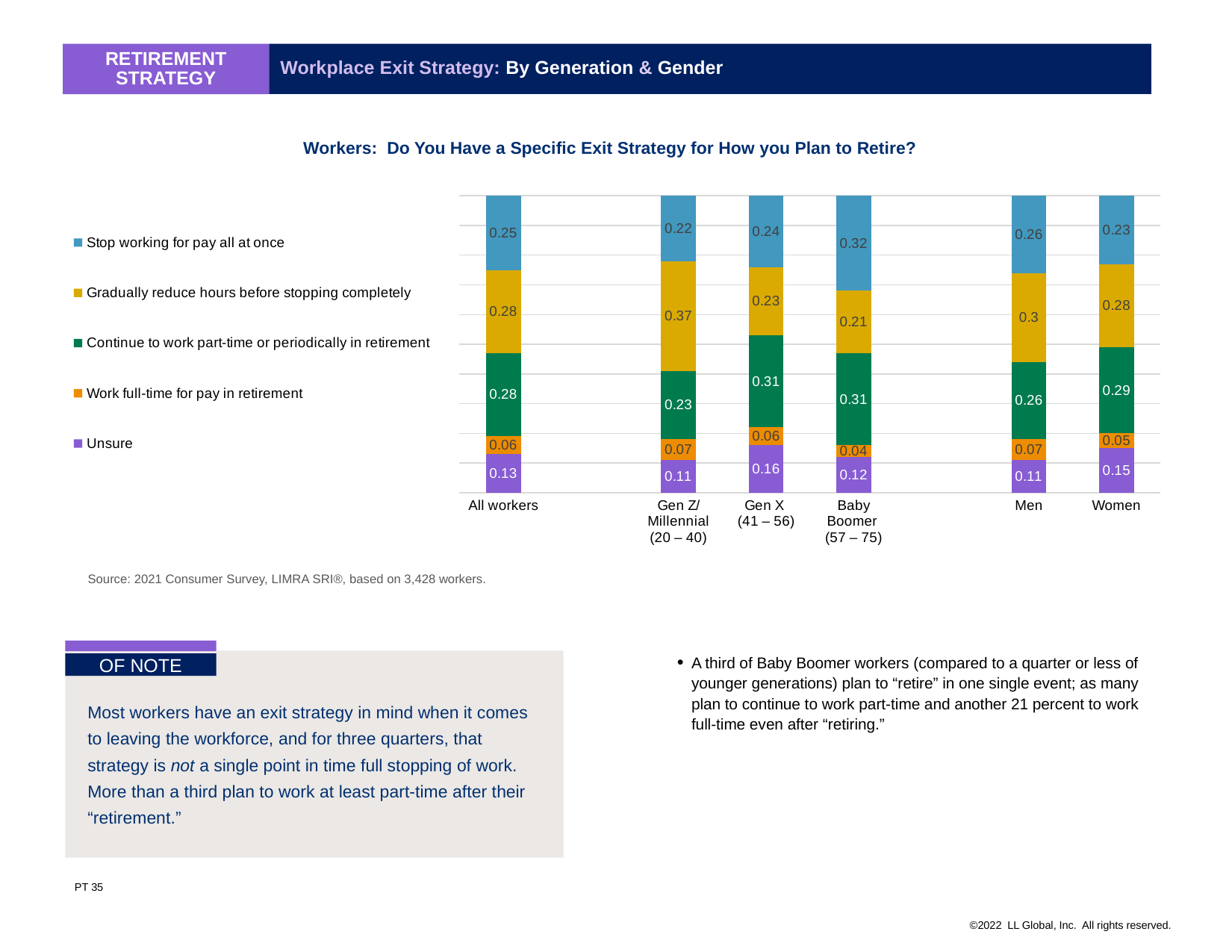
What kind of chart is shown on the slide? Stacked bar chart Which category has the highest value for 'Stop working for pay all at once'? Baby Boomer (57 – 75) What is the 'Unsure' value for Women? 0.15 What is the value for 'Stop working for pay all at once' for Baby Boomer (57 – 75)? 0.32 Which has the larger 'Unsure' value, Gen X (41 – 56) or Gen Z/Millennial (20 – 40)? Gen X (41 – 56) Which category has the lowest value for 'Work full-time for pay in retirement'? Baby Boomer (57 – 75) What is the difference between Men and Women for 'Stop working for pay all at once'? 0.03 How many series does the chart's legend list? 5 What is the value for 'Gradually reduce hours before stopping completely' for Gen Z/Millennial (20 – 40)? 0.37 What is the title of the chart? Workers: Do You Have a Specific Exit Strategy for How you Plan to Retire? Which category has the highest value for 'Gradually reduce hours before stopping completely'? Gen Z/Millennial (20 – 40) How many categories are shown along the x axis of the chart? 6